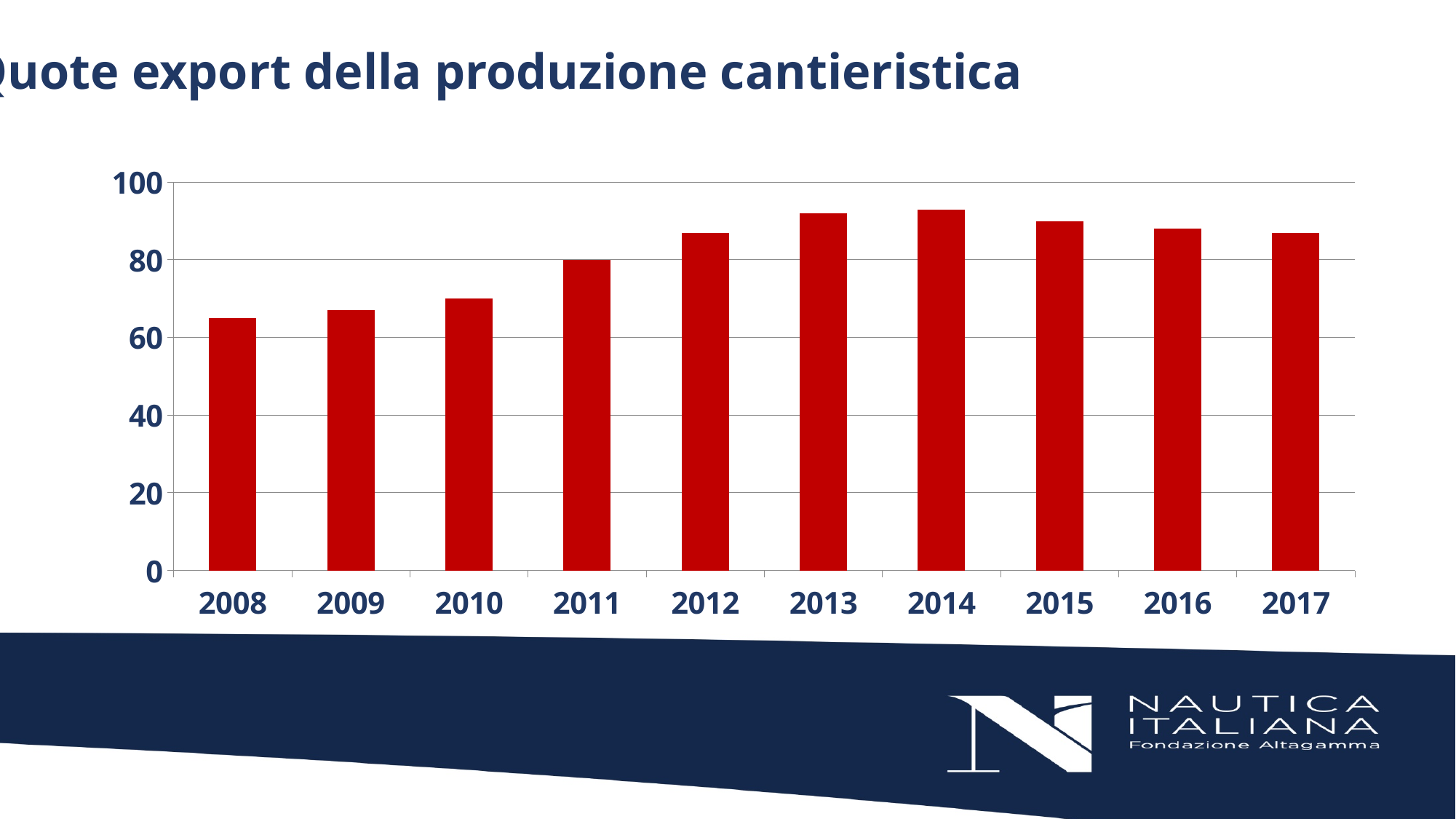
Is the value for 2014 greater or less than 100? less Is the value for 2008 greater or less than 80? less Is the value for 2010 greater or less than 60? greater What kind of chart is shown on the slide? bar chart Which year has the larger value, 2008 or 2013? 2013 What colour are the bars in the chart? red Do the values rise or fall from 2008 to 2014? rise How many years are shown on the x axis of the chart? 10 Which year has the larger value, 2010 or 2012? 2012 What is the title of the chart on the slide? Quote export della produzione cantieristica